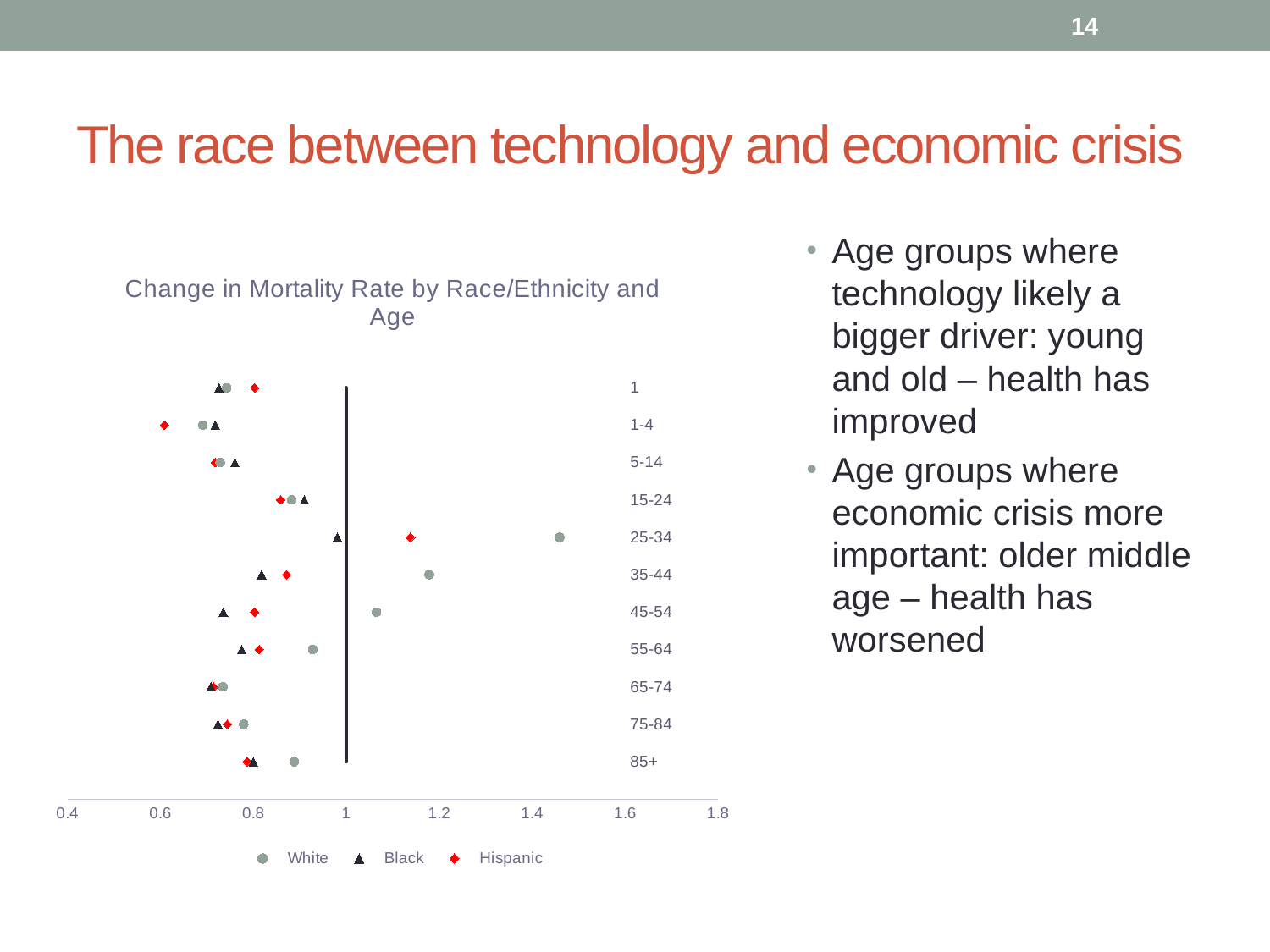
What kind of chart is shown on the slide? scatter (dot) chart How many age groups are plotted on the chart? 11 Which series are listed in the legend? White, Black, Hispanic Is the White value for the 45-54 age group greater or less than 1? greater Which age group has the lowest value for the Hispanic series? 1-4 Is the Hispanic value for the 1-4 age group greater or less than 0.8? less For the 25-34 age group, which is larger: the White value or the Hispanic value? White Is the White value for the 25-34 age group greater or less than 1.2? greater How many series does the legend list? 3 What is the title of the chart? Change in Mortality Rate by Race/Ethnicity and Age For the 35-44 age group, which series has the highest value? White Which age group has the highest value for the White series? 25-34